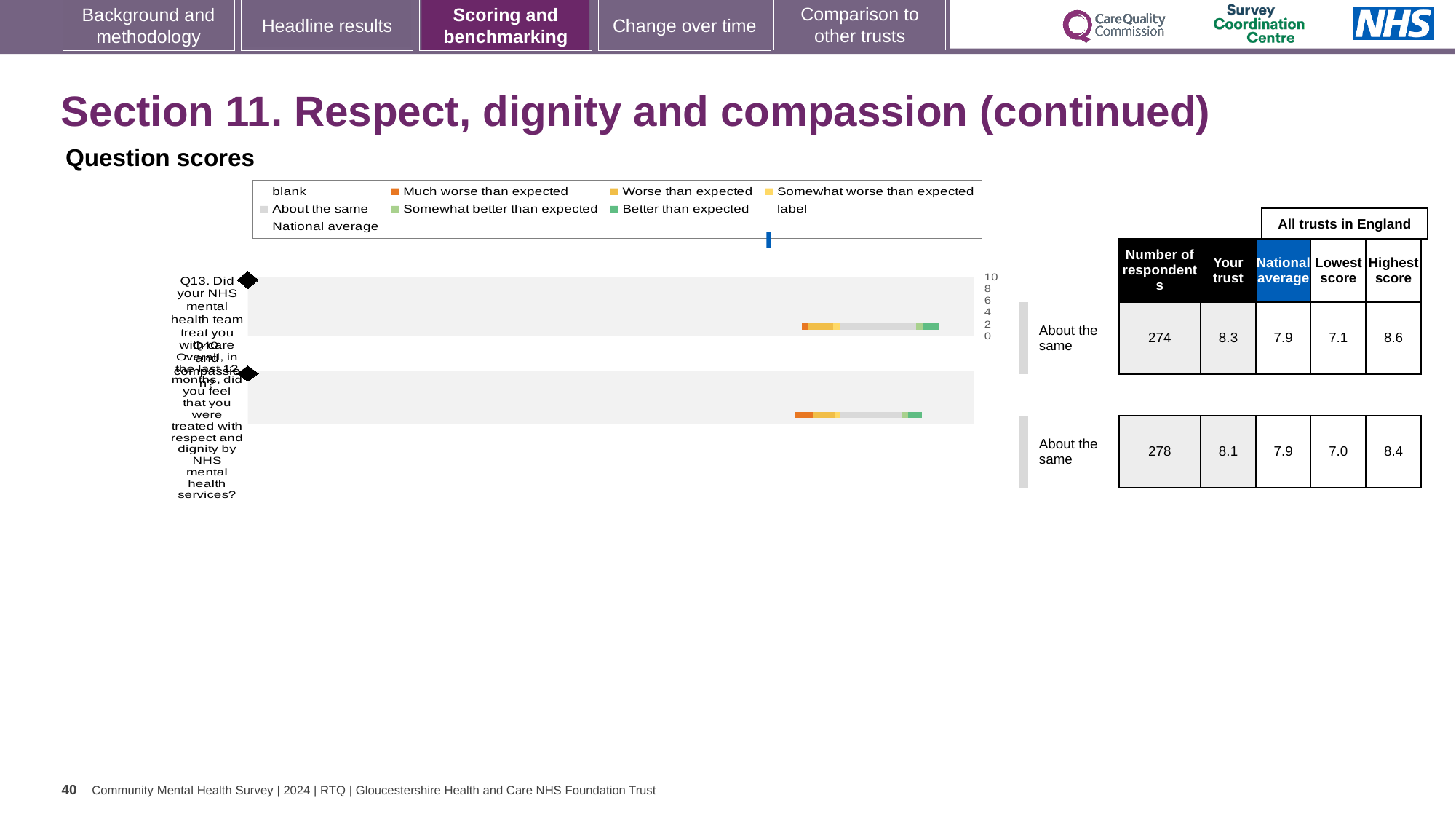
How many respondents are listed for Q14 (treated with respect and dignity)? 278 For Q14, is the 'Your trust' score higher or lower than the national average? higher By how much does the 'Your trust' score for Q13 exceed the national average? 0.4 What is the difference between the highest and lowest scores for Q14? 1.4 What is the highest score among all trusts in England for Q14? 8.4 What is the lowest score among all trusts in England for Q13? 7.1 Which question has more respondents, Q13 or Q14? Q14 How many questions are plotted in the question scores chart? 2 What is the 'Your trust' score for Q13 (treated with care and compassion)? 8.3 What is the national average score for Q13? 7.9 What benchmarking category is shown for Q14? About the same What kind of chart is used to show the question scores on this slide? bar chart